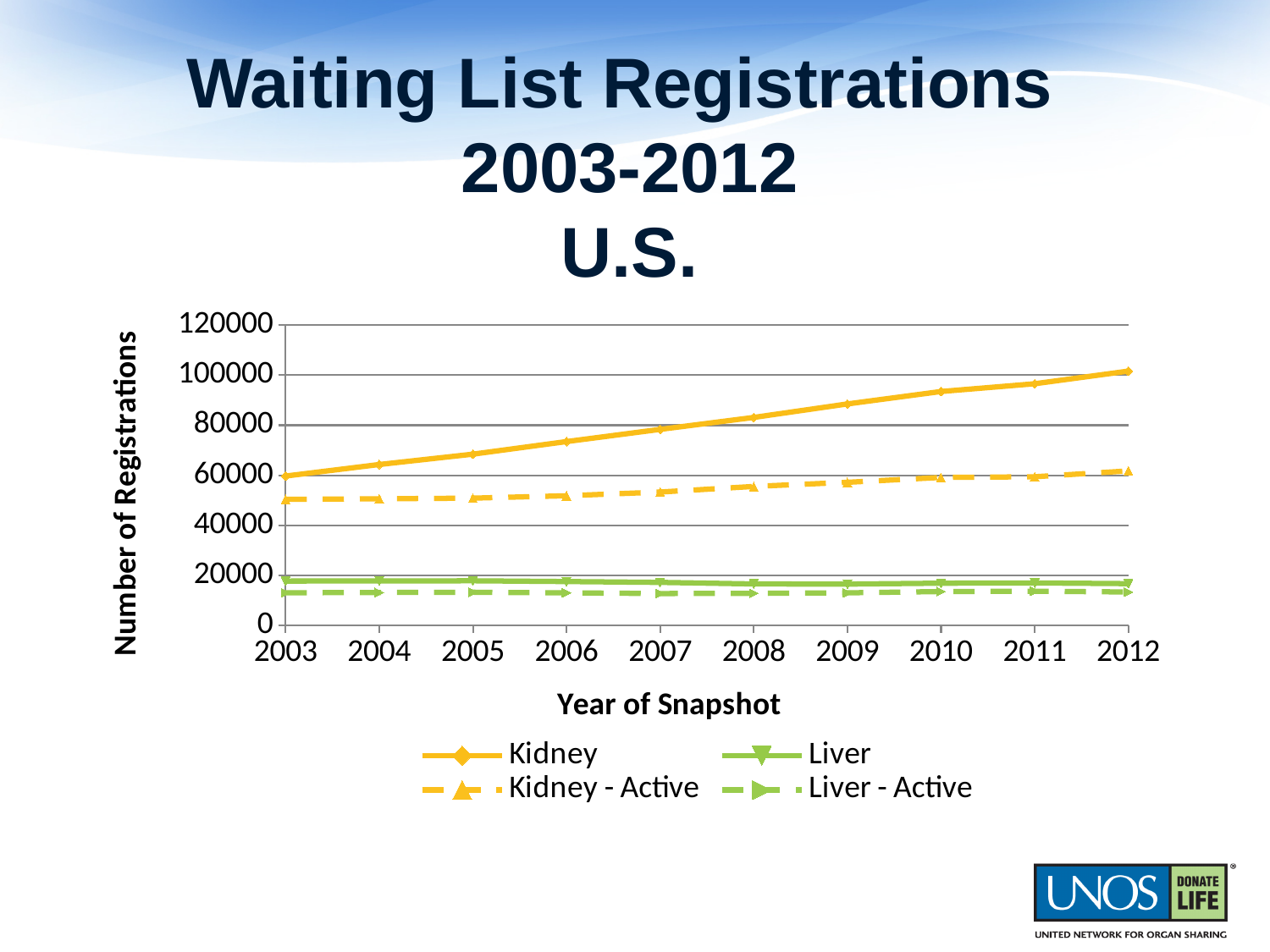
Which series has the lowest values across the chart? Liver - Active Does the Kidney series rise or fall from 2003 to 2012? Rises What is the title of the x axis? Year of Snapshot What kind of chart is shown on the slide? Line chart Is the value for Kidney in 2010 greater or less than 80000? greater How many series does the legend list? 4 In 2012, which is larger, Kidney or Liver? Kidney How many years are plotted along the x axis? 10 Is the value for Kidney - Active in 2003 greater or less than 60000? less Which series has the highest value in 2012? Kidney Is the value for Liver in 2003 greater or less than 20000? less Does the Kidney - Active series rise or fall from 2003 to 2012? Rises